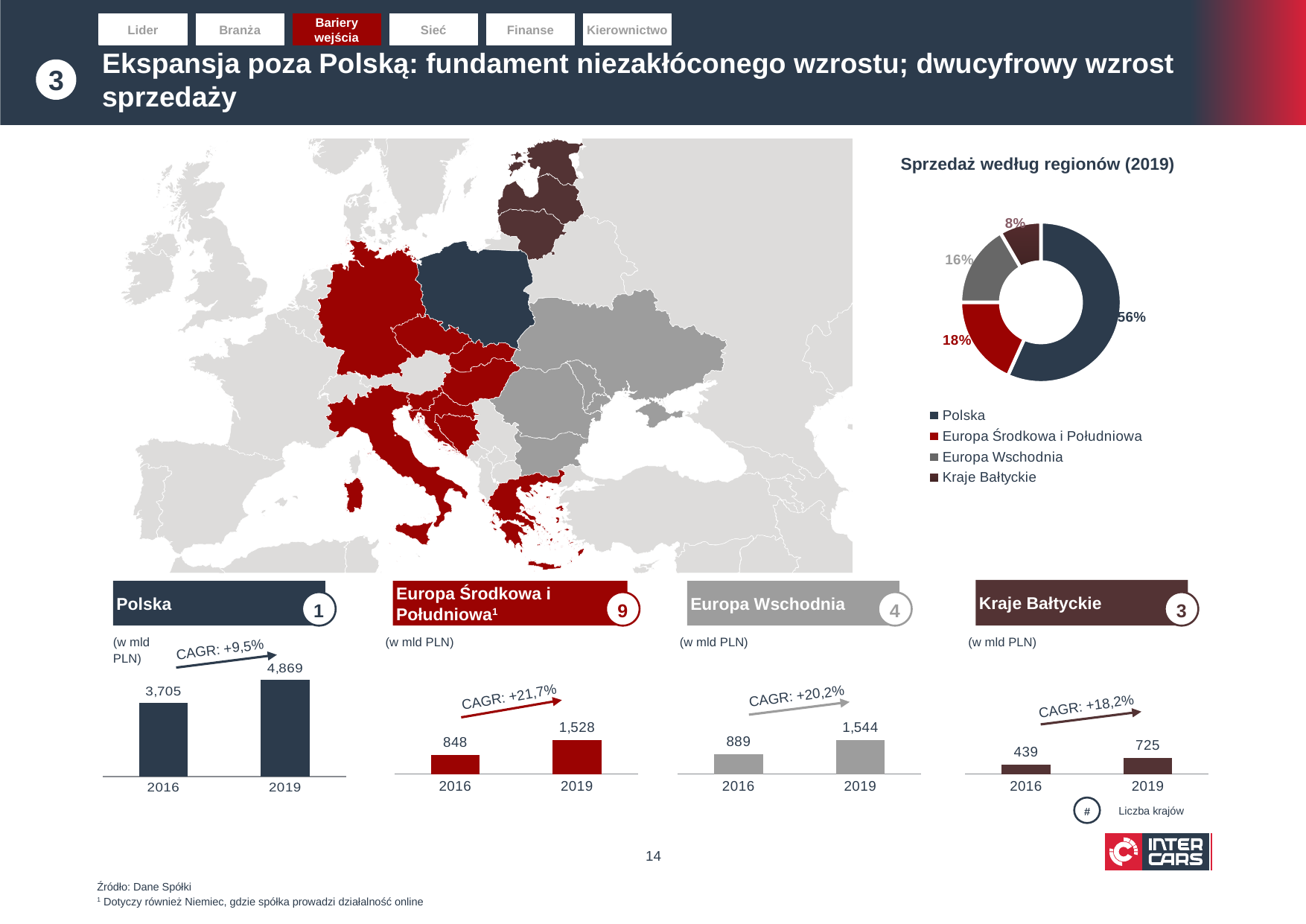
What type of chart is 'Sprzedaż według regionów (2019)'? donut (pie) chart In the 'Sprzedaż według regionów (2019)' donut chart, what share does Polska have? 56% Which is larger: the 2019 value in the 'Europa Wschodnia' chart or the 2019 value in the 'Europa Środkowa i Południowa' chart? Europa Wschodnia In the 'Polska' bar chart, what is the value for 2019? 4,869 In the 'Sprzedaż według regionów (2019)' donut chart, what share does Kraje Bałtyckie have? 8% In the 'Kraje Bałtyckie' bar chart, what is the difference between the 2019 and 2016 values? 286 In the 'Europa Wschodnia' bar chart, what is the value for 2019? 1,544 In the 'Polska' bar chart, what is the difference between the 2019 and 2016 values? 1,164 In the 'Europa Środkowa i Południowa' bar chart, what is the value for 2016? 848 In the 'Sprzedaż według regionów (2019)' donut chart, which region has the smallest share? Kraje Bałtyckie How many entries does the legend of the 'Sprzedaż według regionów (2019)' chart list? 4 In the 'Kraje Bałtyckie' bar chart, do the values rise or fall from 2016 to 2019? rise